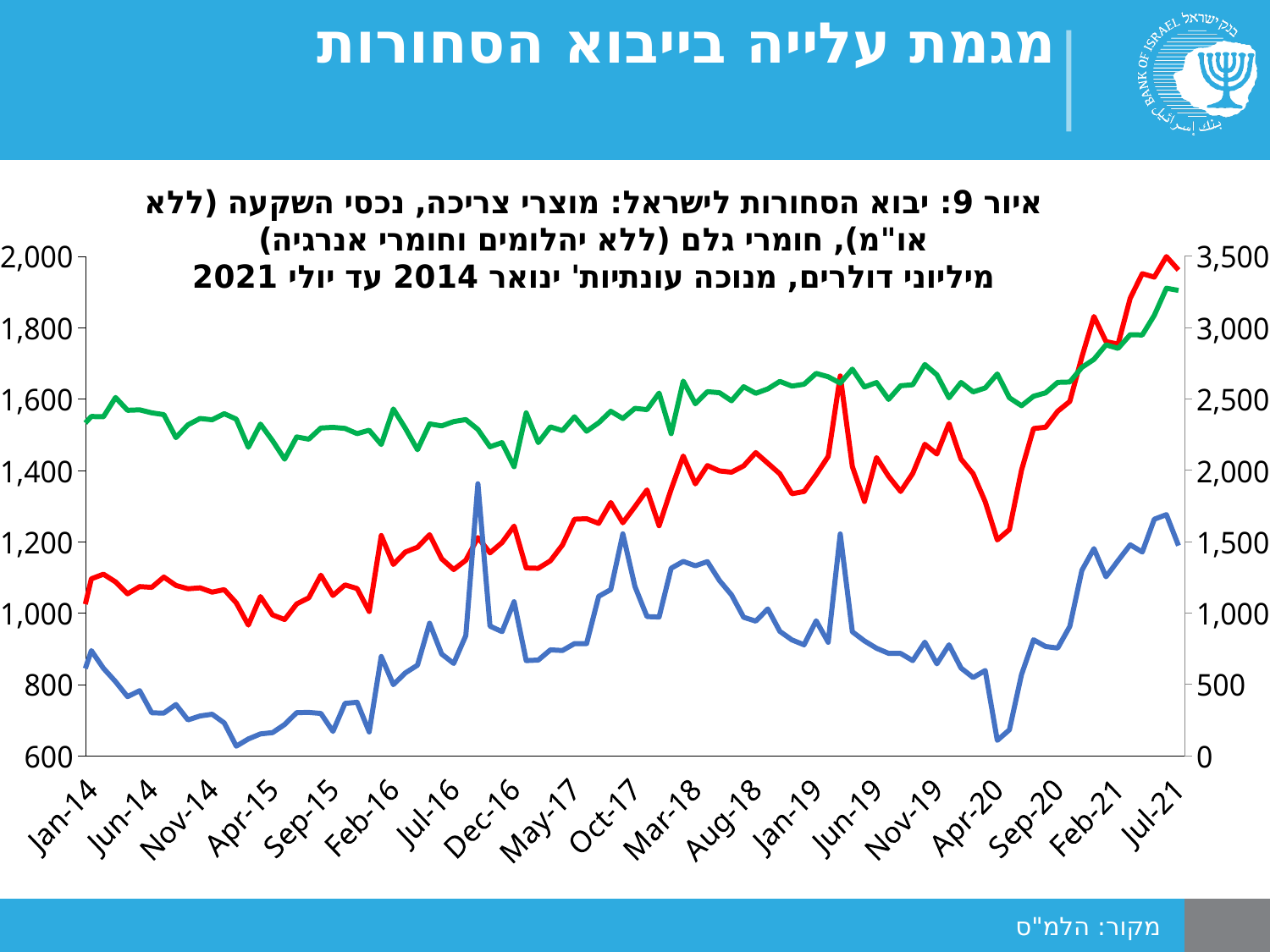
What kind of chart is shown on the slide? line chart Does the red line overall rise or fall from Jan-14 to Jul-21? rise Does the green line overall rise or fall from Jan-14 to Jul-21? rise Does the blue line rise or fall between Jan-20 and Apr-20? fall How many lines are plotted on the chart? 3 Which line is plotted lowest on the chart for most of the period? the blue line What colours are the three lines on the chart? red, green and blue What is the first month label on the x axis of the chart? Jan-14 Which line is plotted highest on the chart for most of the period? the green line